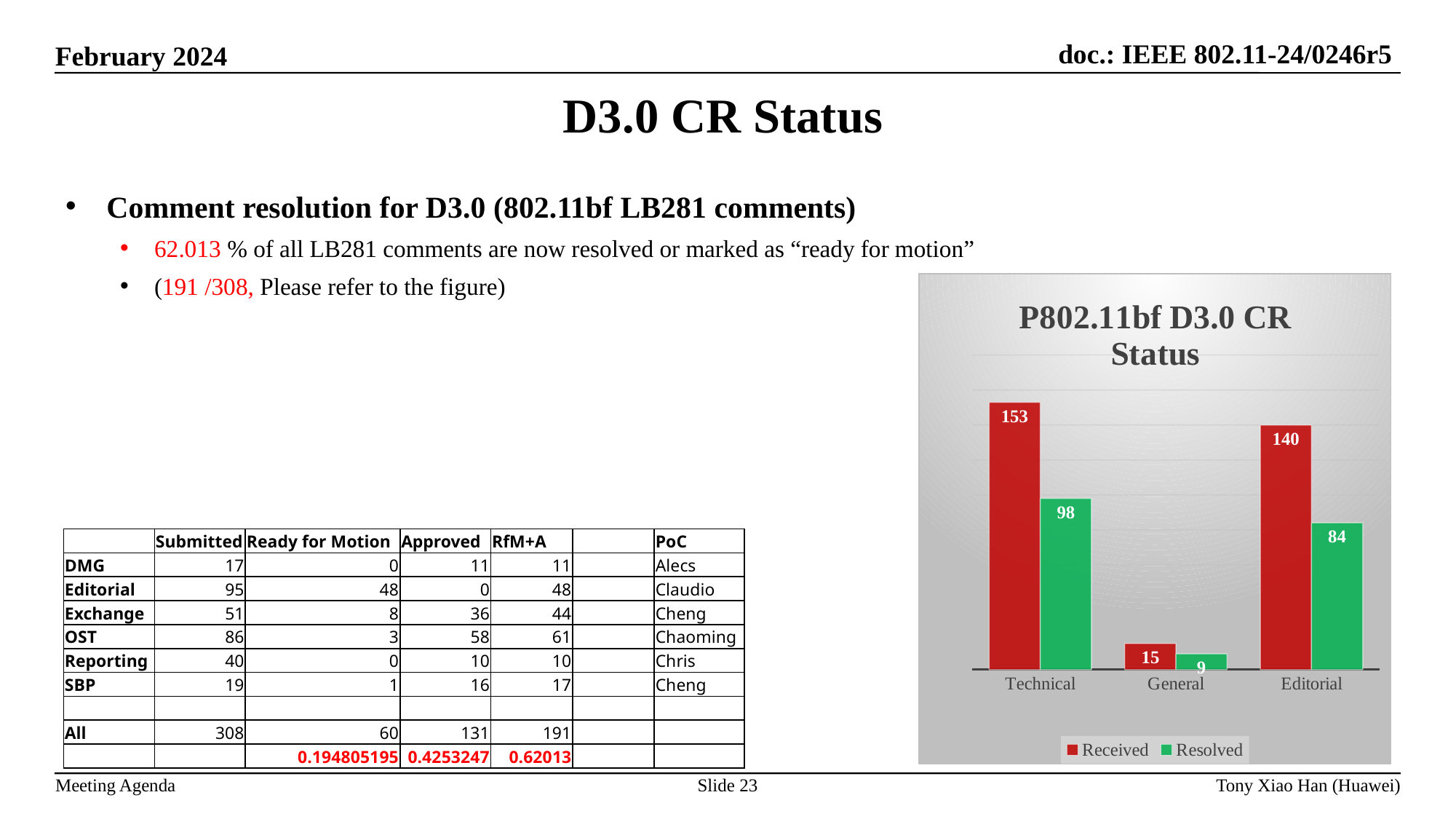
Which category has the highest Received value? Technical Which category has the lowest Resolved value? General What is the title of the chart? P802.11bf D3.0 CR Status How many series does the legend list? 2 What is the difference between Received and Resolved for Editorial? 56 How many categories are shown on the x axis? 3 What is the Resolved value for Editorial? 84 What kind of chart is shown? bar chart What is the Received value for Technical? 153 What is the Resolved value for General? 9 Which is larger, the Resolved value for Technical or the Resolved value for Editorial? Technical What is the difference between Received and Resolved for Technical? 55